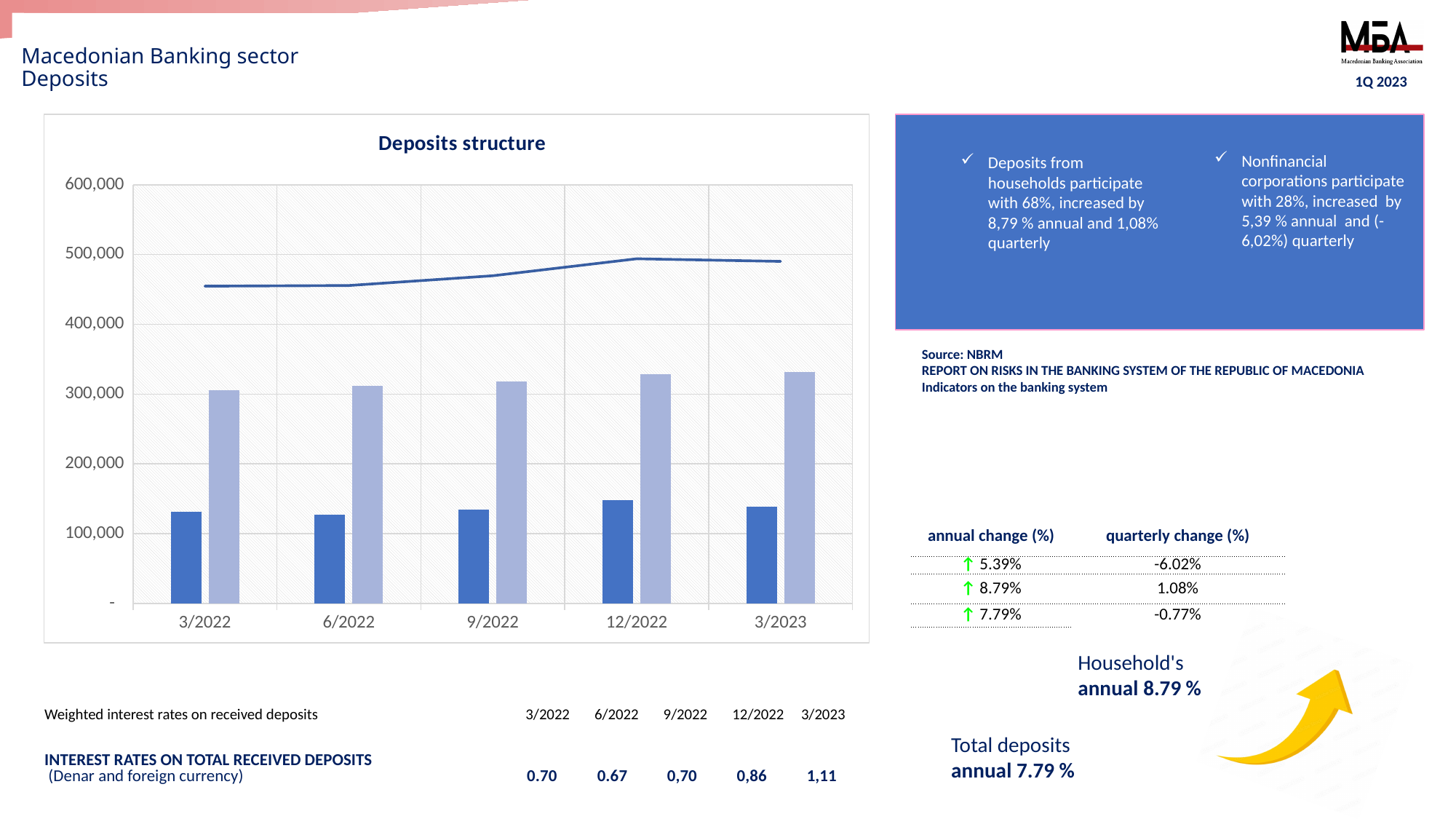
In the "Deposits structure" chart, is the line value for 9/2022 greater or less than 400,000? greater In the "Deposits structure" chart, does the line generally rise or fall from 3/2022 to 12/2022? Rise What kind of chart is the "Deposits structure" chart? A combined bar and line chart In the "Deposits structure" chart, is the dark blue bar for 12/2022 greater or less than 200,000? less In the "Deposits structure" chart, is the dark blue bar for 3/2022 greater or less than 100,000? greater In the "Deposits structure" chart, which is larger for 6/2022: the dark blue bar or the light blue bar? The light blue bar What is the title of the chart on the slide? Deposits structure How many time periods are shown on the x axis of the "Deposits structure" chart? 5 In the "Deposits structure" chart, how many bars are plotted for each period? 2 In the "Deposits structure" chart, which period has the highest dark blue bar? 12/2022